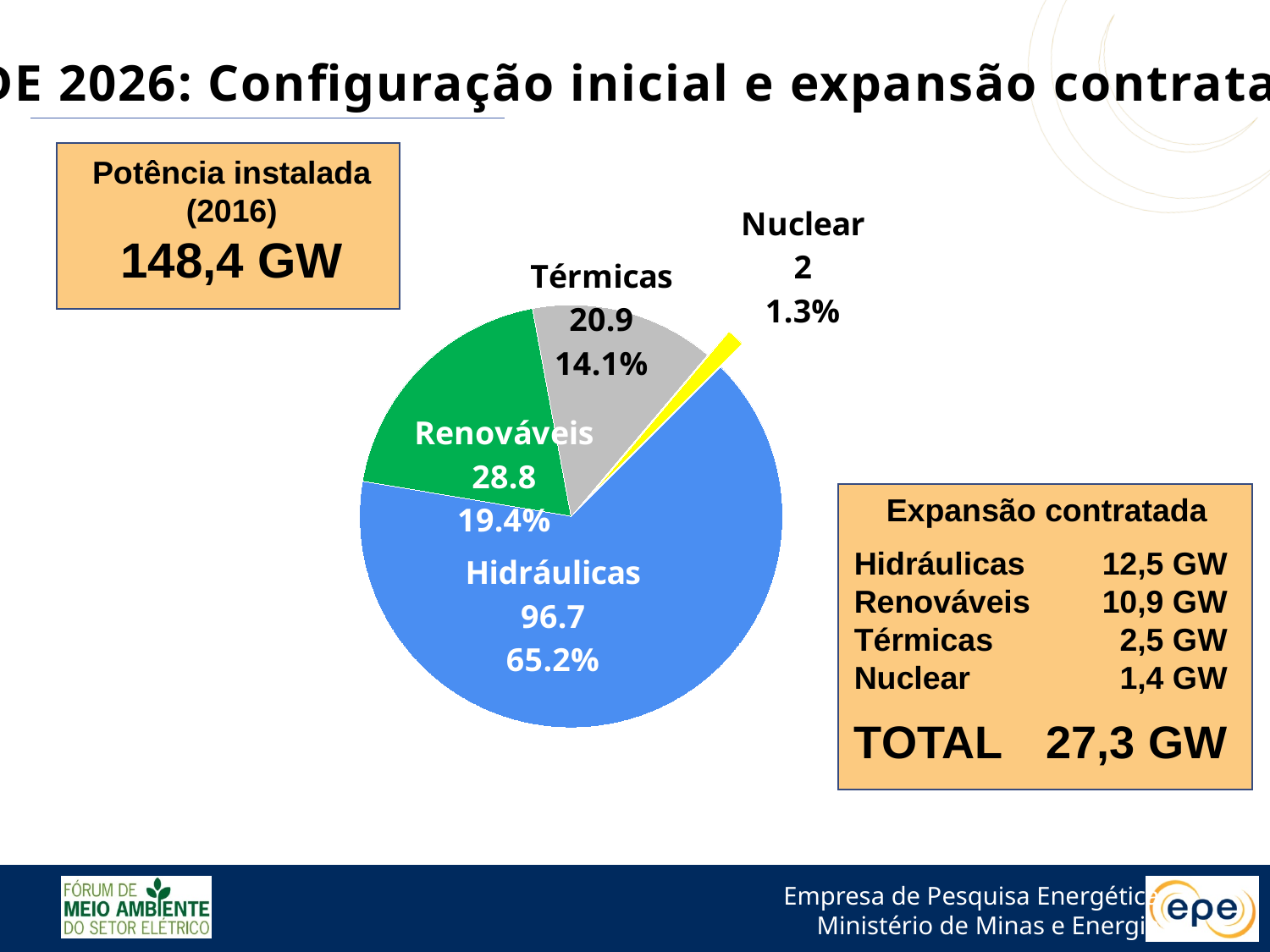
Which is larger, the Renováveis slice or the Térmicas slice? Renováveis What is the difference between the values for Renováveis and Térmicas? 7.9 What percentage share does the Hidráulicas slice have? 65.2% What percentage share does the Renováveis slice have? 19.4% How many slices does the pie chart have? 4 What is the value shown for Térmicas in the pie chart? 20.9 Which category has the largest slice of the pie? Hidráulicas Which category has the smallest slice of the pie? Nuclear What kind of chart is shown on the slide? pie chart What is the value shown for Hidráulicas in the pie chart? 96.7 What percentage share does the Nuclear slice have? 1.3% What colour is the Nuclear slice? yellow